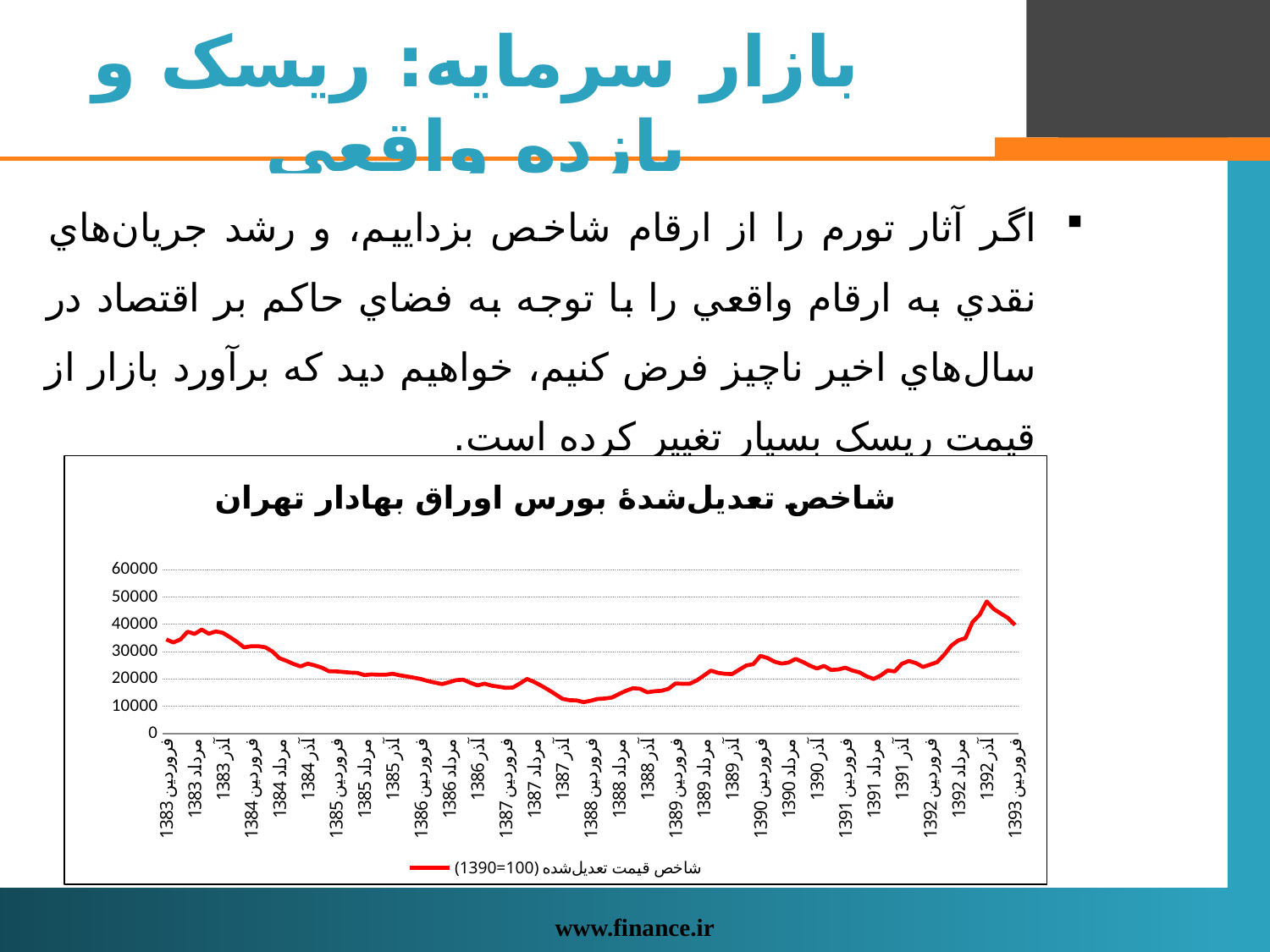
Around which x-axis label does the line reach its lowest value? فروردین 1388 Does the line rise or fall between فروردین 1383 and فروردین 1388? fall What is the title of the chart? شاخص تعدیل‌شدهٔ بورس اوراق بهادار تهران Is the value for فروردین 1383 greater or less than 30000? greater Is the value for فروردین 1388 greater or less than 20000? less Is the value for آذر 1392 greater or less than 40000? greater Which is larger, the value at فروردین 1383 or the value at فروردین 1388? فروردین 1383 What is the legend entry for the plotted line? شاخص قیمت تعدیل‌شده (1390=100) What kind of chart is shown on the slide? line chart How many series does the chart legend list? 1 Around which x-axis label does the line reach its highest value? آذر 1392